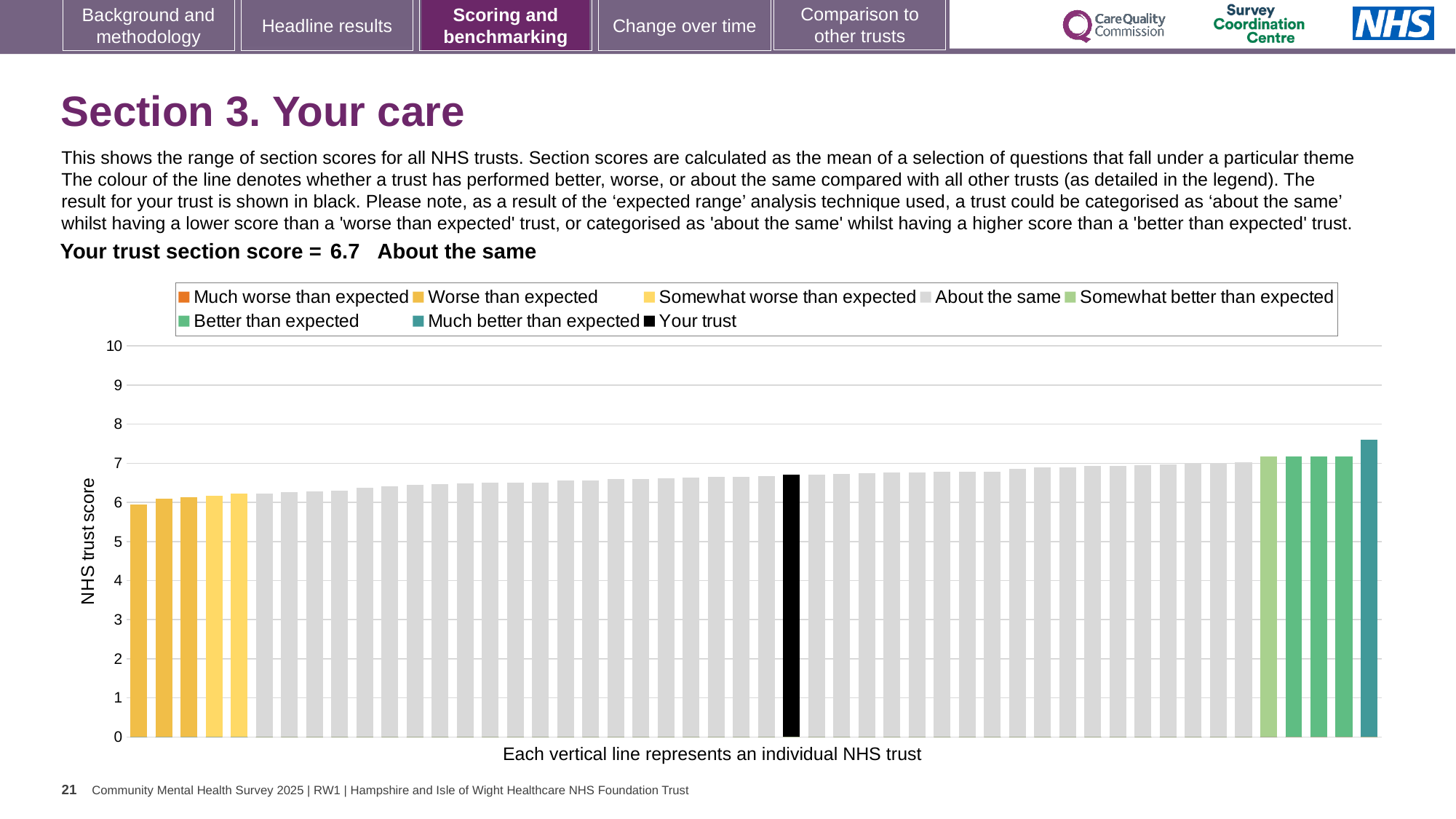
Do the bar values rise or fall from left to right along the x axis? rise Which performance category is your trust placed in for this section? About the same How many entries does the chart legend list? 8 Is the value of the tallest bar greater or less than 7? greater Is the value of the shortest bar greater or less than 7? less What is the label on the vertical axis of the chart? NHS trust score What kind of chart is shown on the slide? bar chart How many bars are coloured teal for 'Much better than expected'? 1 What colour is the bar representing your trust? black What is the section score for your trust shown on the slide? 6.7 Is the value of the bar for your trust greater or less than 5? greater Which legend category does the tallest bar belong to? Much better than expected